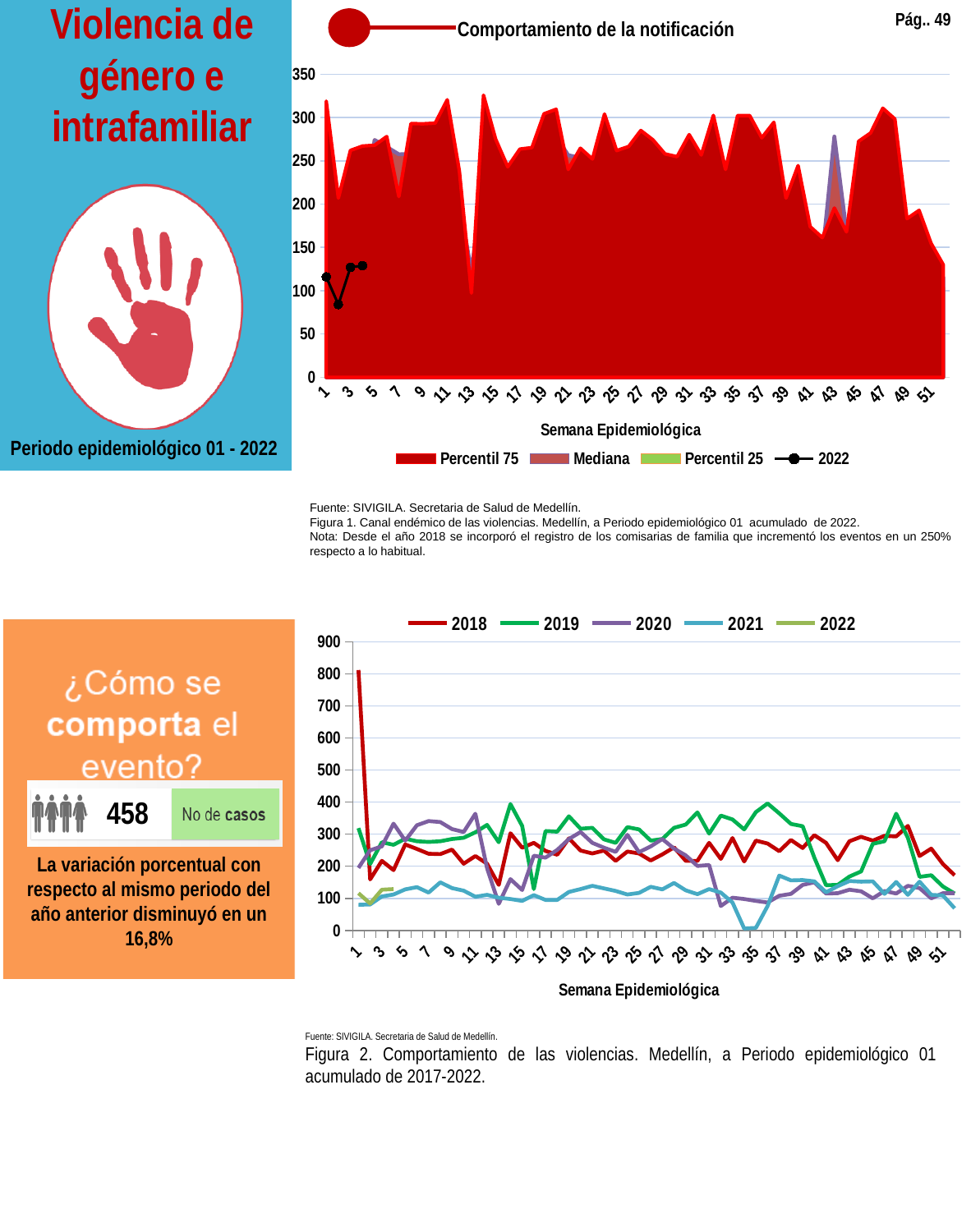
In the top chart 'Comportamiento de la notificación', is the value of the 2022 line at week 4 greater or less than 100? greater In the bottom chart (Figura 2), at week 1, which series has the larger value, 2018 or 2019? 2018 In the bottom chart (Figura 2), how many series does the legend list? 5 In the bottom chart (Figura 2), what kind of chart is shown? line chart In the top chart 'Comportamiento de la notificación', is the Percentil 75 value at week 14 greater or less than 300? greater In the top chart 'Comportamiento de la notificación', is the value of the 2022 line at week 2 greater or less than 100? less In the bottom chart (Figura 2), which series reaches the highest value on the chart? 2018 In the top chart 'Comportamiento de la notificación', what is the title of the horizontal axis? Semana Epidemiológica In the top chart 'Comportamiento de la notificación', how many series does the legend list? 4